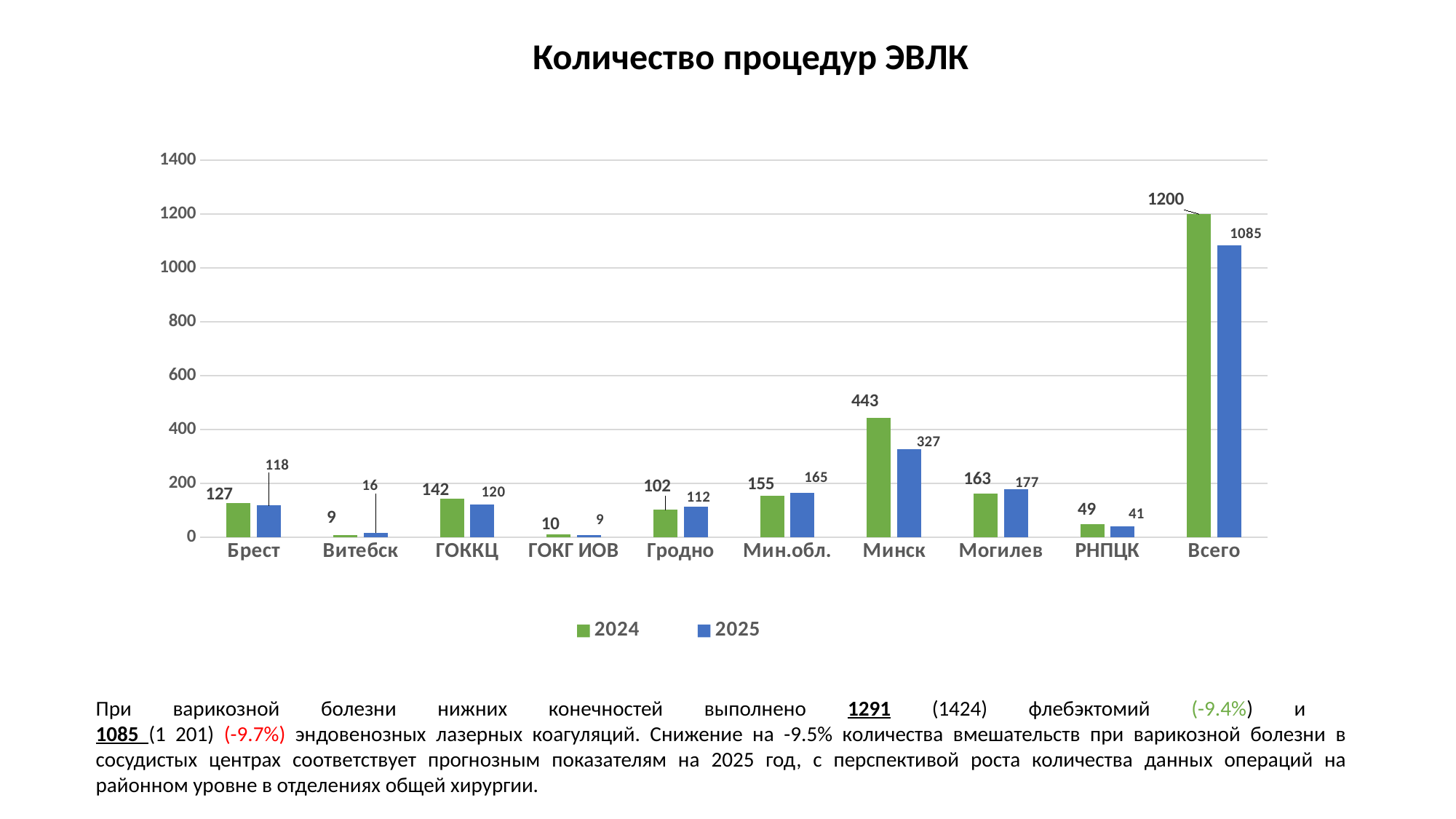
How many series does the legend list? 2 What is the difference between the 2024 and 2025 values for Минск? 116 Which is larger for Могилев: the 2024 value or the 2025 value? 2025 What is the value for Всего in the 2025 series? 1085 How many categories are shown on the x axis? 10 Which category has the lowest 2025 value? ГОКГ ИОВ Excluding Всего, which category has the highest 2024 value? Минск What is the title of the chart? Количество процедур ЭВЛК What is the value for Гродно in the 2025 series? 112 What is the value for Минск in the 2024 series? 443 What kind of chart is shown on the slide? bar chart Is the 2024 value for Всего greater or less than 1000? greater